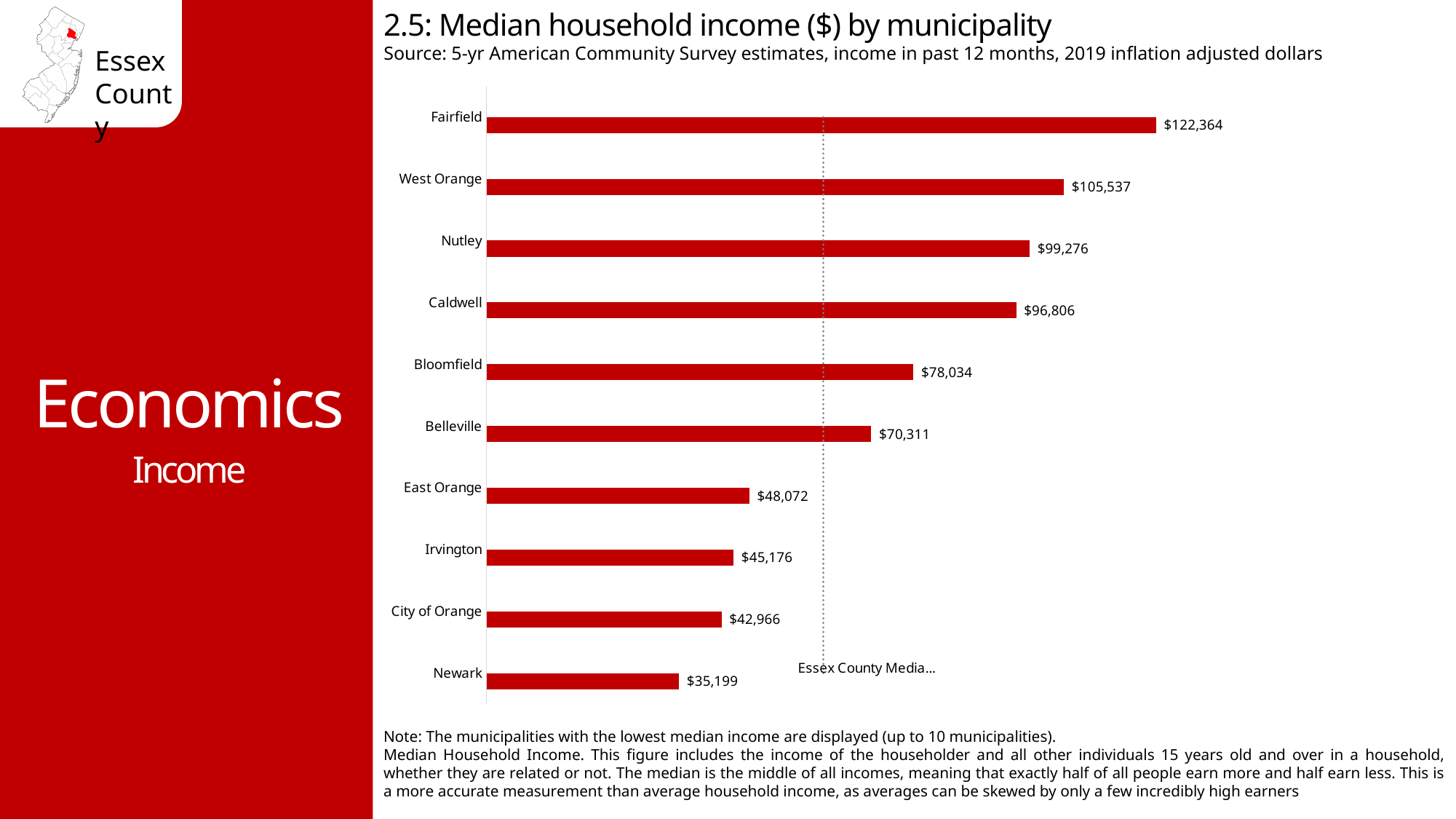
What is the median household income for City of Orange? $42,966 What does the dotted vertical line on the chart represent? Essex County Median Which has a higher median household income, Irvington or East Orange? East Orange What is the median household income for Belleville? $70,311 Which municipality has the highest median household income on the chart? Fairfield What is the difference between the median household income of Nutley and Caldwell? $2,470 What kind of chart is used to show median household income by municipality? Bar chart How many municipalities are shown on the chart? 10 Which municipality has the lowest median household income on the chart? Newark Which has a higher median household income, West Orange or Bloomfield? West Orange What is the difference between the median household income of Fairfield and Newark? $87,165 What is the median household income for Fairfield? $122,364